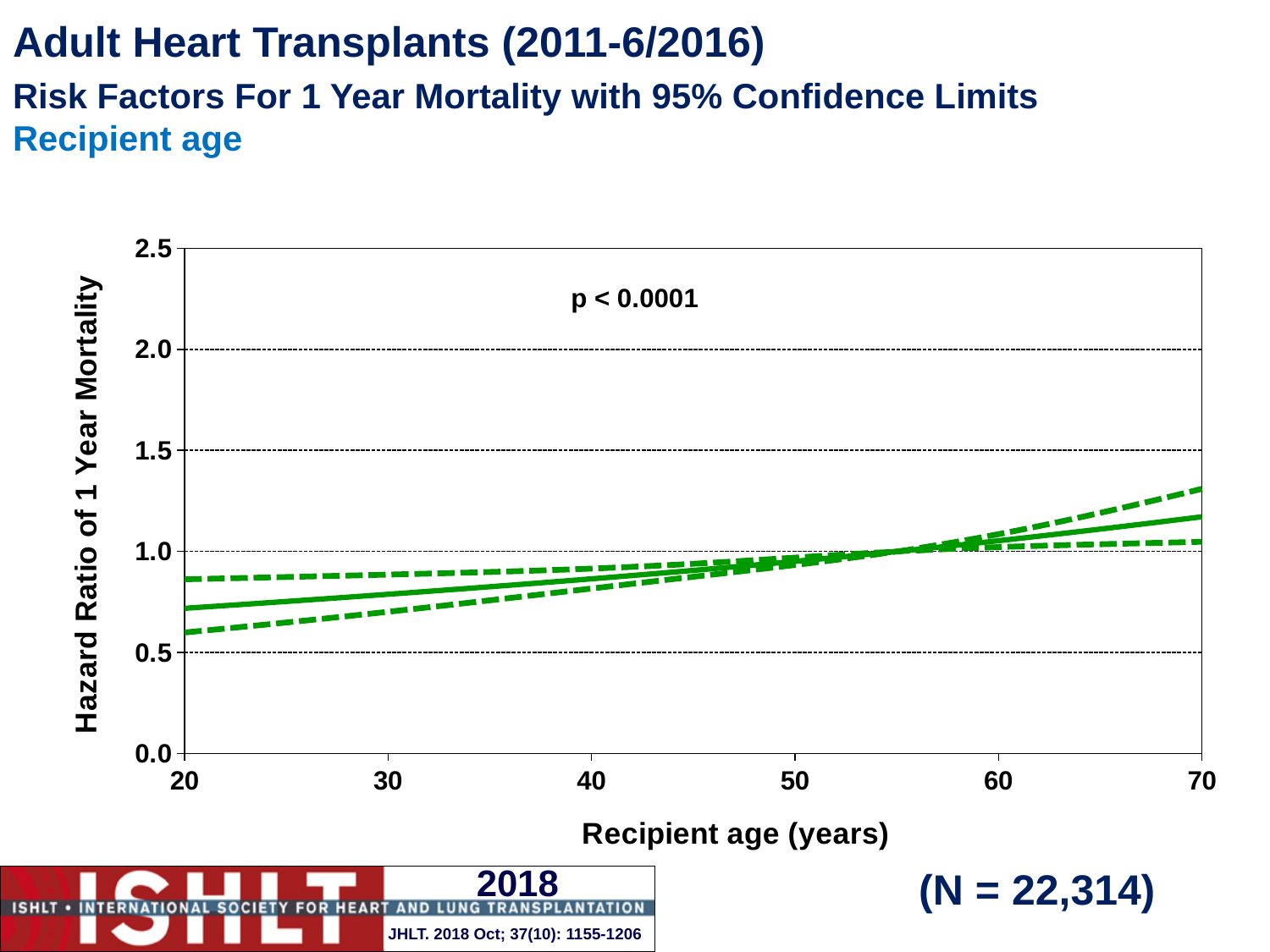
What kind of chart is shown on the slide? line chart Which recipient age has the larger hazard ratio on the solid line, 20 years or 70 years? 70 years Is the hazard ratio (solid line) at recipient age 70 greater or less than 1.0? greater Is the lower confidence limit (lower dashed line) at recipient age 20 greater or less than 0.5? greater What is the sample size (N) shown on the slide? N = 22,314 What p-value is printed on the chart? p < 0.0001 Does the hazard ratio of 1 year mortality rise or fall as recipient age increases from 20 to 70 years? rise Is the upper confidence limit (upper dashed line) at recipient age 20 greater or less than 1.0? less How many lines are plotted on the chart? 3